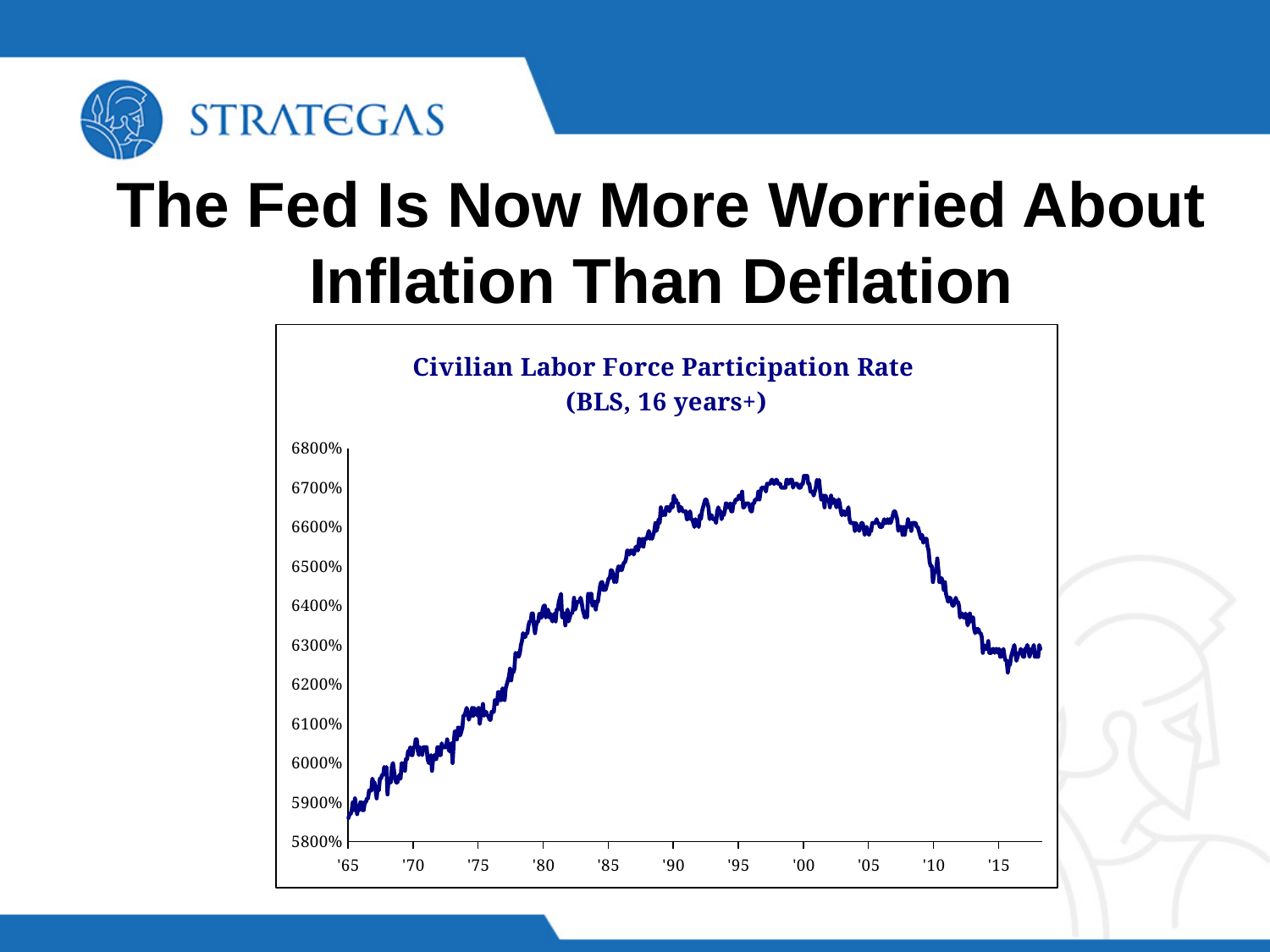
Which of the labeled years, '65 or '05, has the higher participation rate? '05 Is the value at '75 greater or less than 6000%? greater What is the title of the chart? Civilian Labor Force Participation Rate (BLS, 16 years+) Is the value at '00 greater or less than 6600%? greater Is the value at '80 greater or less than 6300%? greater Does the labor force participation rate rise or fall between '00 and '15? fall What kind of chart is shown on the slide? line chart Does the labor force participation rate rise or fall between '65 and '00? rise How many year labels are shown on the x axis? 11